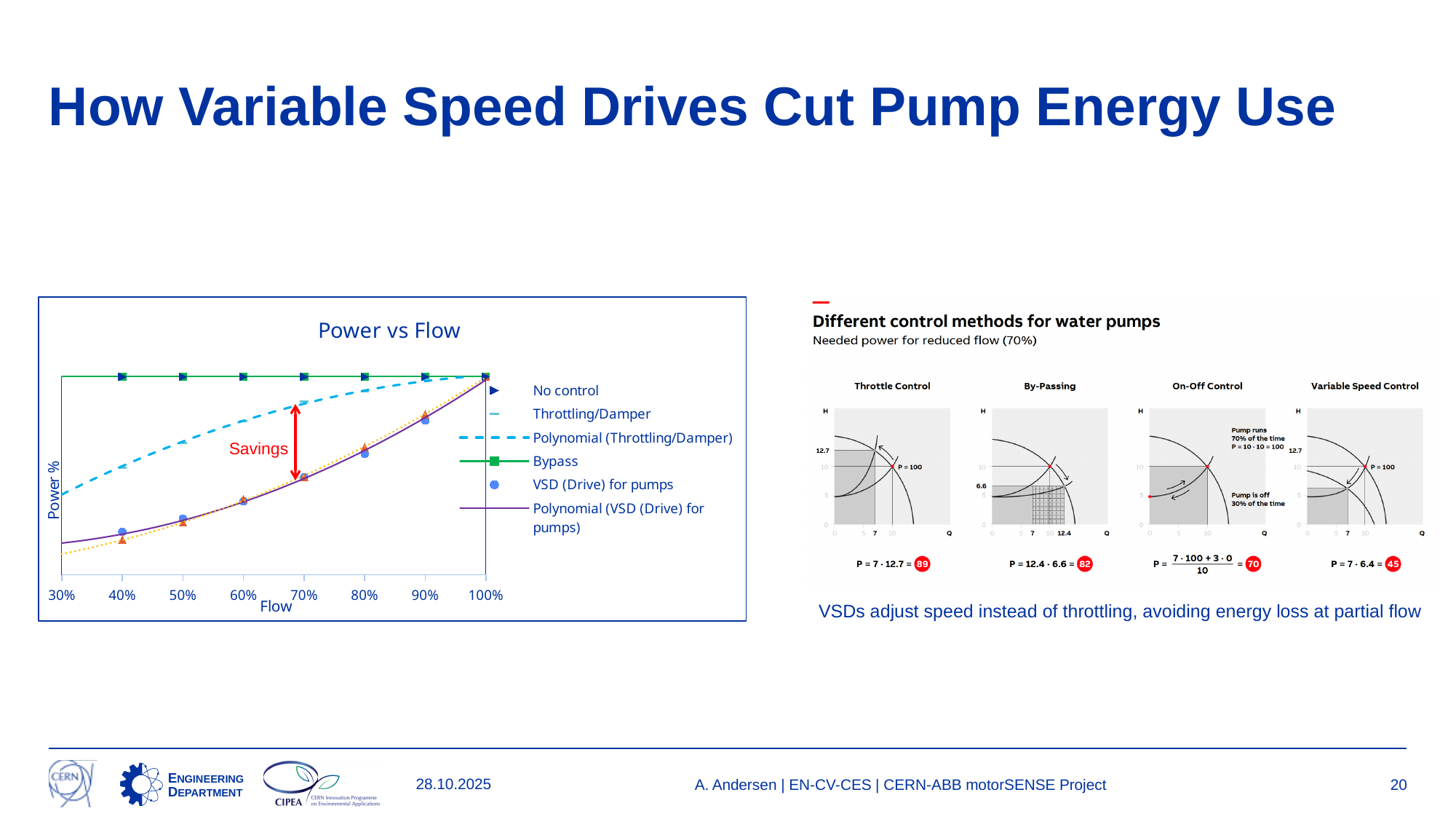
How many flow percentage labels are shown on the x axis of the Power vs Flow chart? 8 In the Power vs Flow chart, how many series does the legend list? 6 What is the title of the chart on the left of the slide? Power vs Flow What kind of chart is the Power vs Flow chart? Line chart In the Power vs Flow chart, does the Bypass series rise, fall or stay flat as flow increases? Stays flat In the 'Different control methods for water pumps' figure on the right, what is the difference in needed power between Throttle Control and Variable Speed Control? 44 In the Power vs Flow chart, what does the red arrow between the throttling curve and the VSD curve represent? Savings In the Power vs Flow chart, which series has the highest power at 50% flow? Bypass and No control (tied at the top) In the Power vs Flow chart, does the VSD (Drive) for pumps series rise or fall as flow increases? Rises In the 'Different control methods for water pumps' figure on the right, what is the needed power P for Variable Speed Control? 45 In the 'Different control methods for water pumps' figure on the right, which control method needs the lowest power at 70% flow? Variable Speed Control In the Power vs Flow chart, at 70% flow, which is higher: the Polynomial (Throttling/Damper) curve or the VSD (Drive) for pumps series? Polynomial (Throttling/Damper)